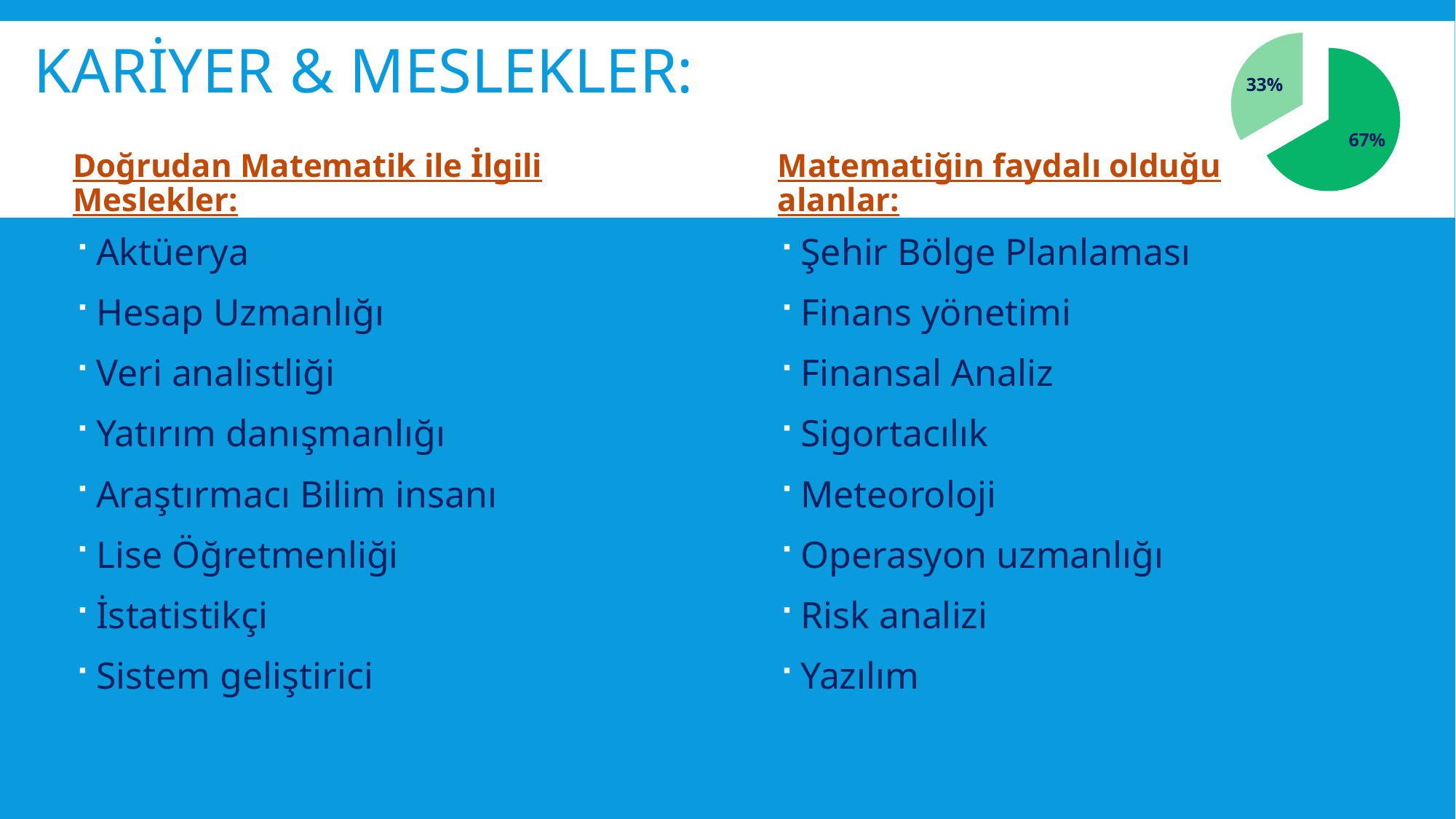
Is the dark green slice of the pie chart larger or smaller than the light green slice? larger What kind of chart is shown in the top-right corner of the slide? pie chart Does the pie chart have a legend? No What share of the pie does the dark green slice represent? 67% Which slice of the pie chart is pulled out (exploded) from the rest? the light green 33% slice What percentage is shown on the larger, dark green slice of the pie chart? 67% Is the value of the light green slice of the pie chart greater or less than 50%? less Which slice of the pie chart is the largest, the dark green one or the light green one? the dark green one How many slices does the pie chart have? 2 Which slice of the pie chart is the smallest, the dark green one or the light green one? the light green one What is the difference in percentage points between the two slices of the pie chart? 34 What percentage is shown on the smaller, light green slice of the pie chart? 33%